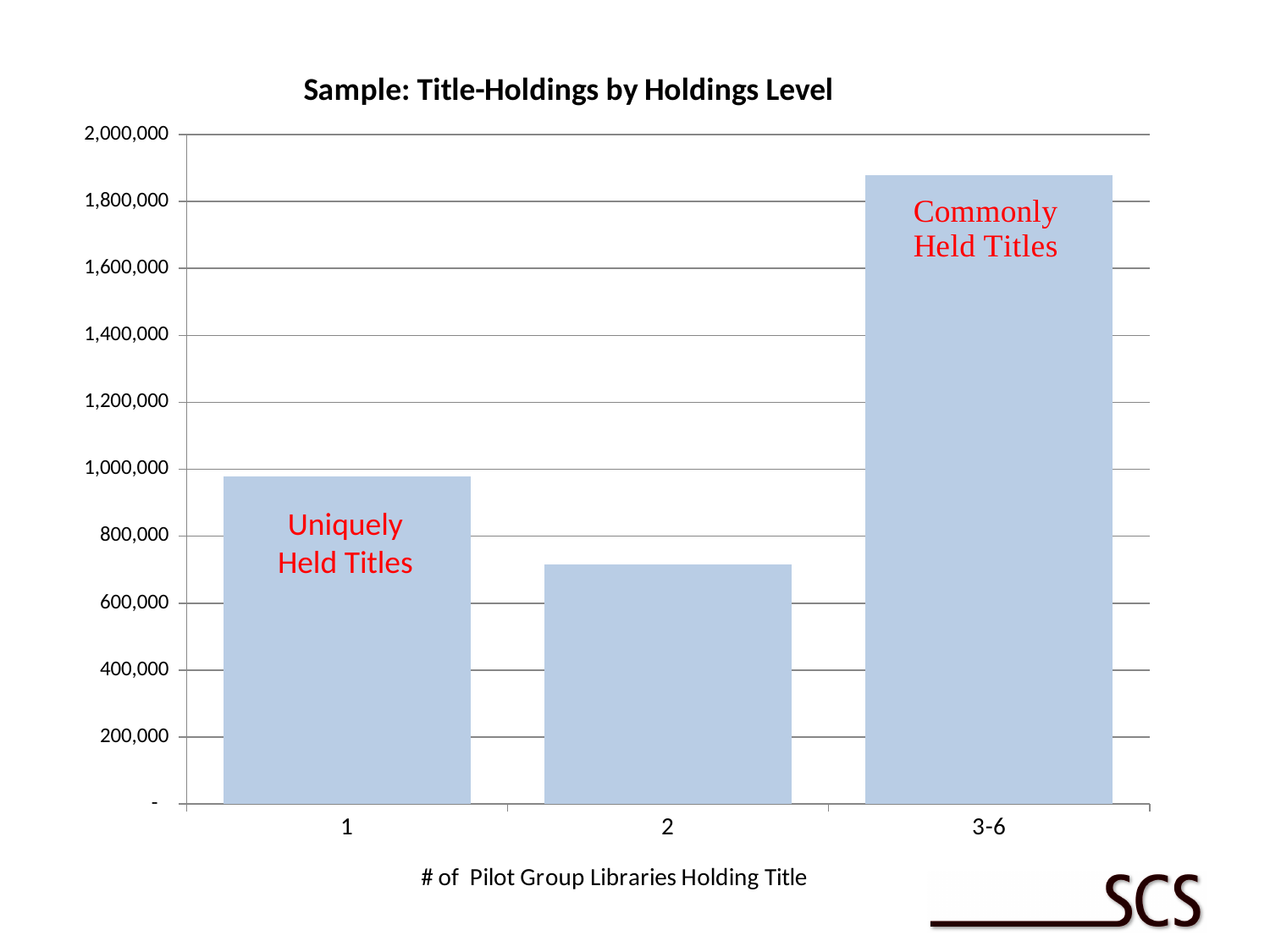
How many categories are shown on the x axis of the chart? 3 Is the value for category 1 greater or less than 800,000? greater Which category has the lowest value in the chart? 2 Is the value for category 2 greater or less than 600,000? greater Which is larger, the value for category 1 or the value for category 2? 1 Is the value for category 3-6 greater or less than 1,800,000? greater What kind of chart is shown on the slide? bar chart What is the title of the chart? Sample: Title-Holdings by Holdings Level Which category has the highest value in the chart? 3-6 What is the label on the x axis of the chart? # of Pilot Group Libraries Holding Title